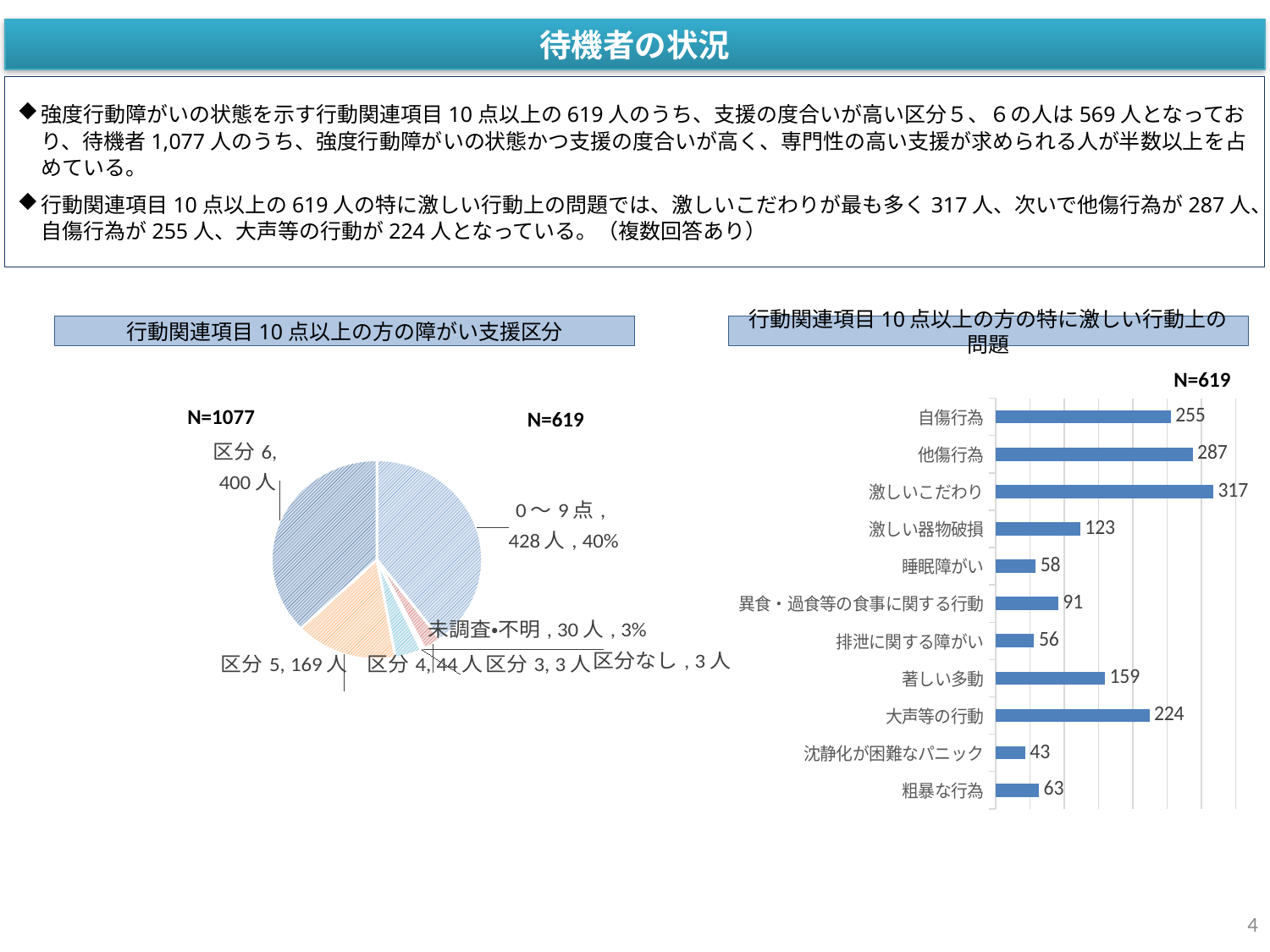
What kind of chart is the one titled 行動関連項目10点以上の方の特に激しい行動上の問題? Bar chart In the pie chart titled 行動関連項目10点以上の方の障がい支援区分, how many people are in 区分6? 400人 In the pie chart titled 行動関連項目10点以上の方の障がい支援区分, which slice is the largest? 0～9点 In the bar chart titled 行動関連項目10点以上の方の特に激しい行動上の問題, what is the value for 激しいこだわり? 317 In the bar chart titled 行動関連項目10点以上の方の特に激しい行動上の問題, which is larger, 自傷行為 or 著しい多動? 自傷行為 In the bar chart titled 行動関連項目10点以上の方の特に激しい行動上の問題, how many categories are shown? 11 In the bar chart titled 行動関連項目10点以上の方の特に激しい行動上の問題, what is the value for 大声等の行動? 224 In the bar chart titled 行動関連項目10点以上の方の特に激しい行動上の問題, what is the difference between the values for 激しいこだわり and 他傷行為? 30 In the bar chart titled 行動関連項目10点以上の方の特に激しい行動上の問題, which category has the lowest value? 沈静化が困難なパニック In the bar chart titled 行動関連項目10点以上の方の特に激しい行動上の問題, which category has the highest value? 激しいこだわり In the pie chart titled 行動関連項目10点以上の方の障がい支援区分, what share of the pie is 0～9点? 40%